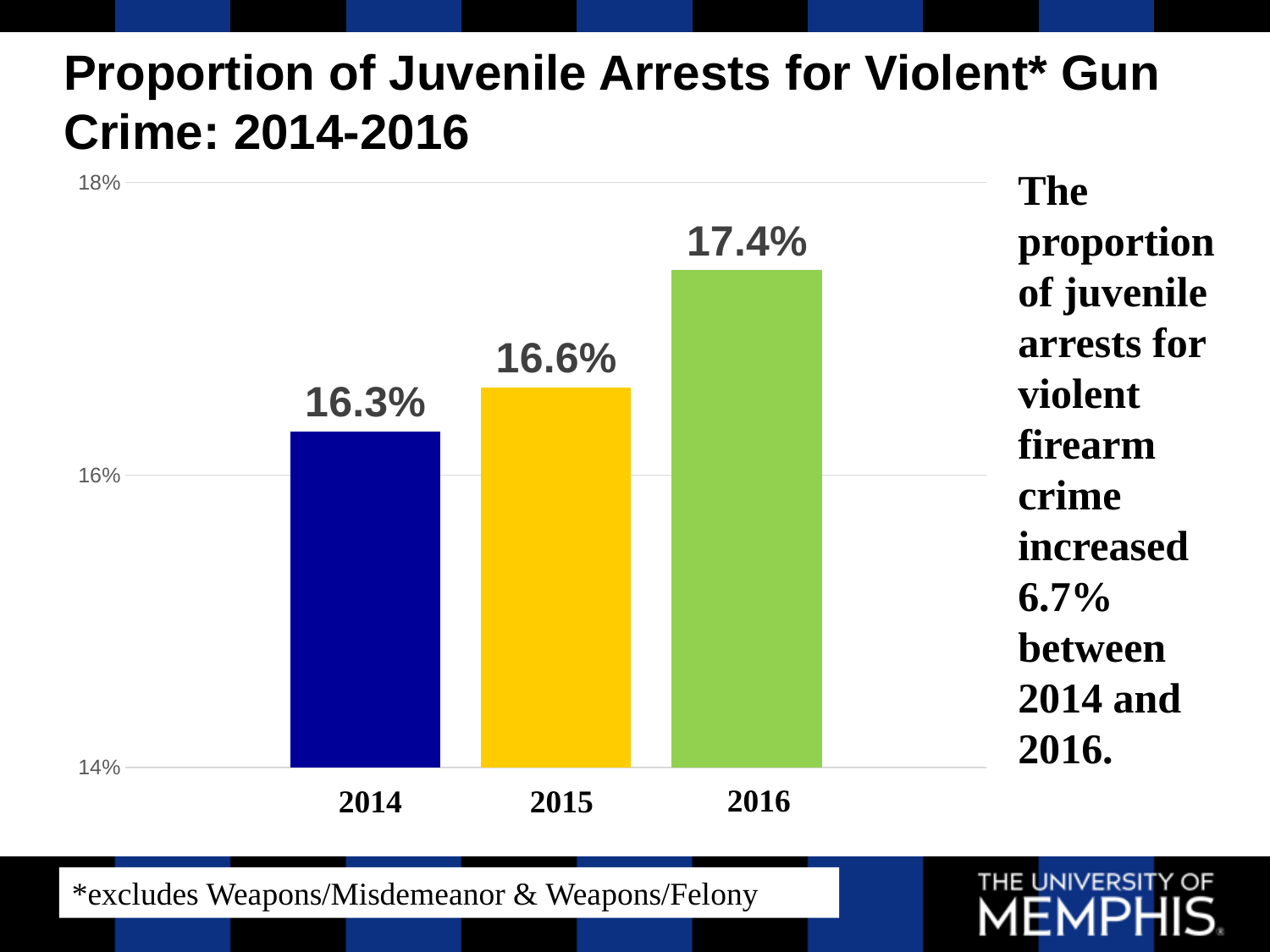
Do the values rise or fall from 2014 to 2016? Rise Which year has the lowest proportion of juvenile arrests for violent gun crime? 2014 Which year has a larger value, 2015 or 2016? 2016 What is the proportion of juvenile arrests for violent gun crime in 2016? 17.4% What is the difference in percentage points between the 2016 and 2014 values? 1.1 What kind of chart is shown on the slide? Bar chart Is the value for 2016 greater or less than 16%? greater What is the proportion of juvenile arrests for violent gun crime in 2014? 16.3% Which year has the highest proportion of juvenile arrests for violent gun crime? 2016 What is the proportion of juvenile arrests for violent gun crime in 2015? 16.6% What is the difference in percentage points between the 2015 and 2014 values? 0.3 How many years are shown on the chart? 3